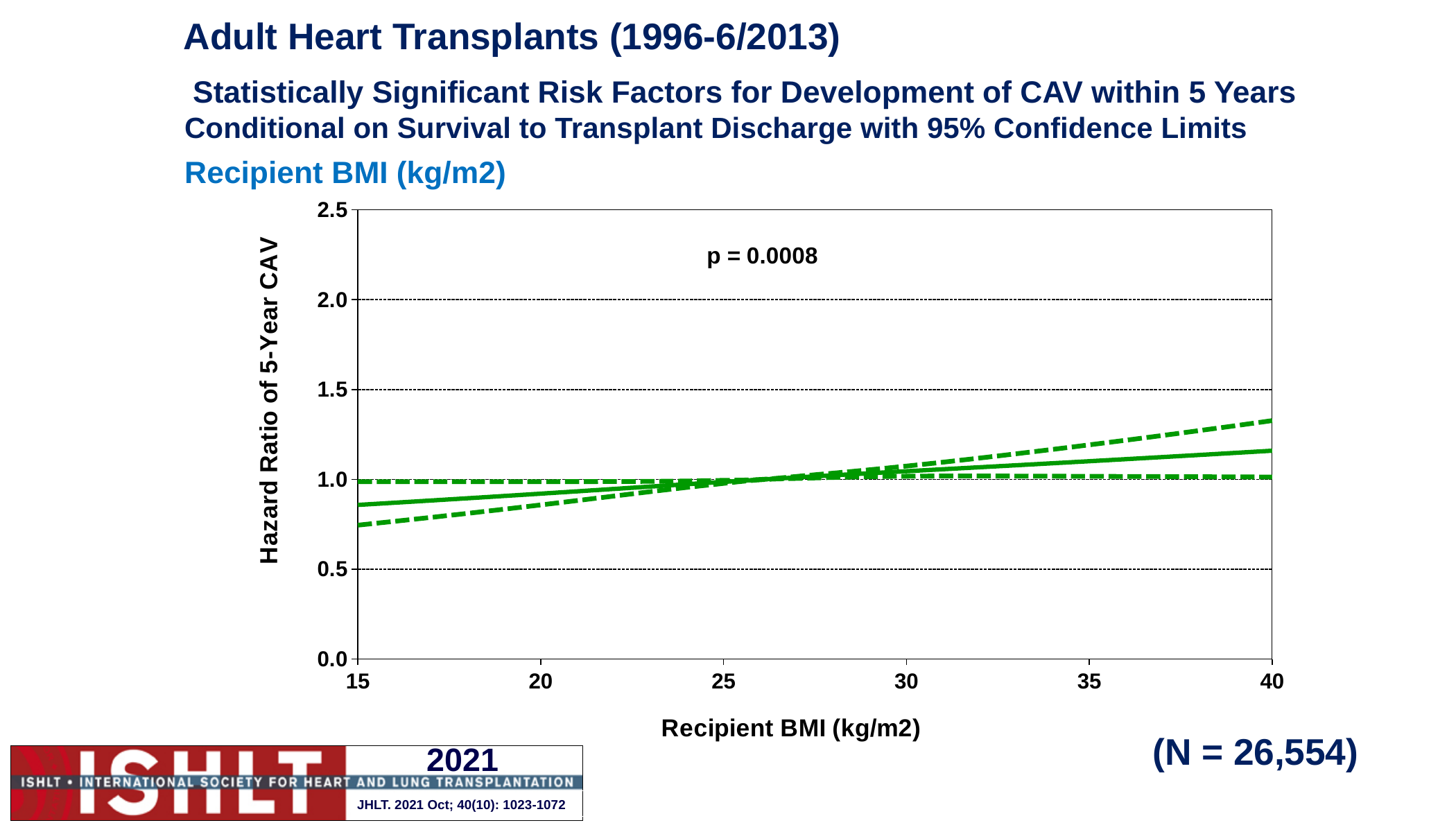
Does the solid hazard ratio line rise or fall as recipient BMI increases from 15 to 40? rises What sample size (N) is shown on the slide? N = 26,554 What p-value is printed on the chart? p = 0.0008 Is the upper dashed confidence limit at a recipient BMI of 40 greater or less than 1.5? less Is the lower dashed confidence limit at a recipient BMI of 15 greater or less than 0.5? greater Is the hazard ratio on the solid line at a recipient BMI of 15 greater or less than 1.0? less What kind of chart is shown on the slide? line chart How many lines are plotted on the chart? 3 What is the label of the y axis? Hazard Ratio of 5-Year CAV What is the label of the x axis? Recipient BMI (kg/m2) What is the highest value shown on the y axis? 2.5